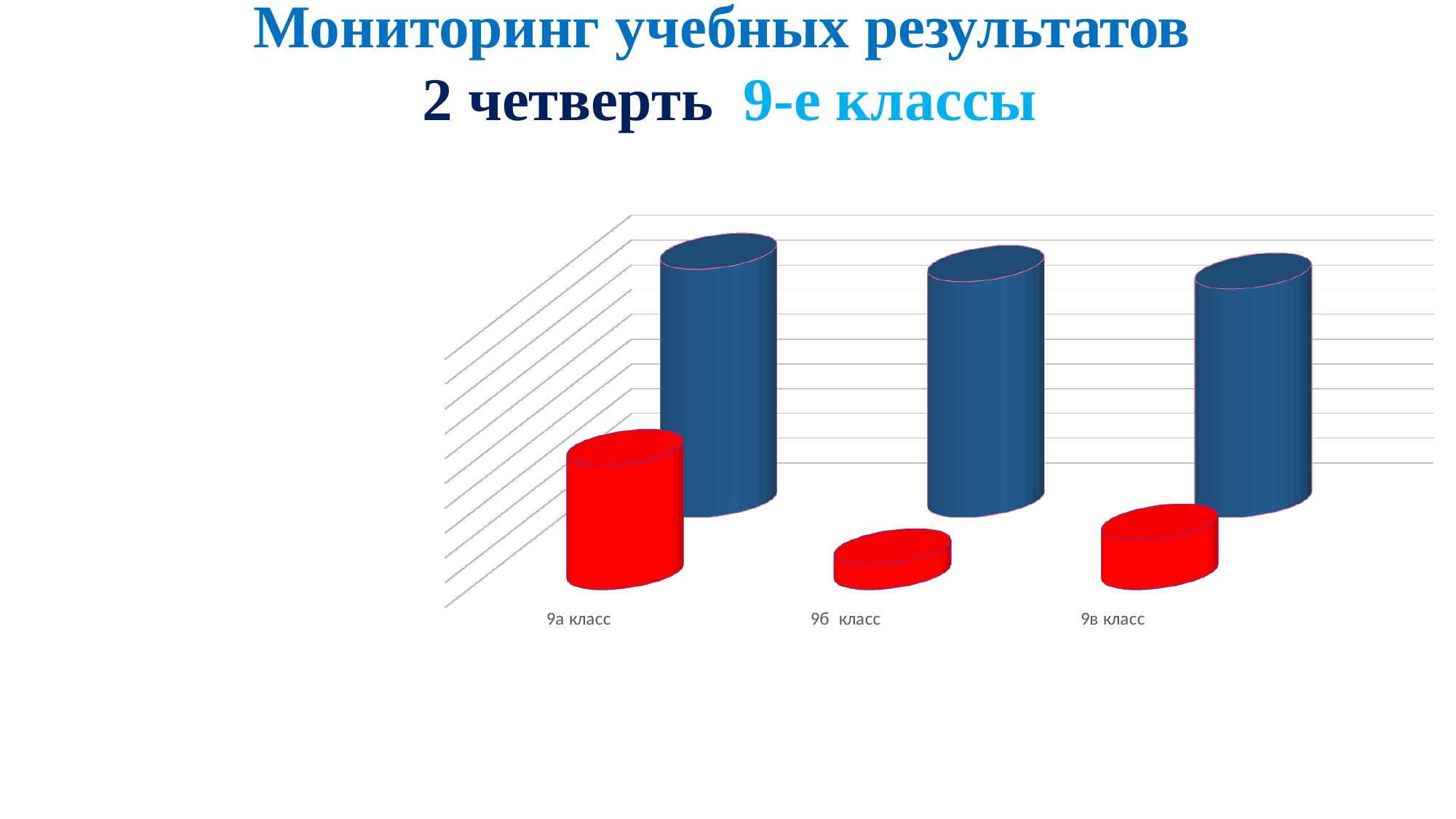
Which class has the tallest red bar? 9а класс What kind of chart is shown on the slide? bar chart Is the red bar for 9в класс taller or shorter than the red bar for 9б класс? taller What is the label of the middle category on the x axis? 9б класс For 9а класс, which bar is taller, the blue one or the red one? the blue one Which class has the shortest red bar? 9б класс What two colours are used for the bars in the chart? blue and red For 9б класс, which bar is taller, the blue one or the red one? the blue one What is the title of the slide containing the chart? Мониторинг учебных результатов 2 четверть 9-е классы How many classes (categories) are shown on the x axis of the chart? 3